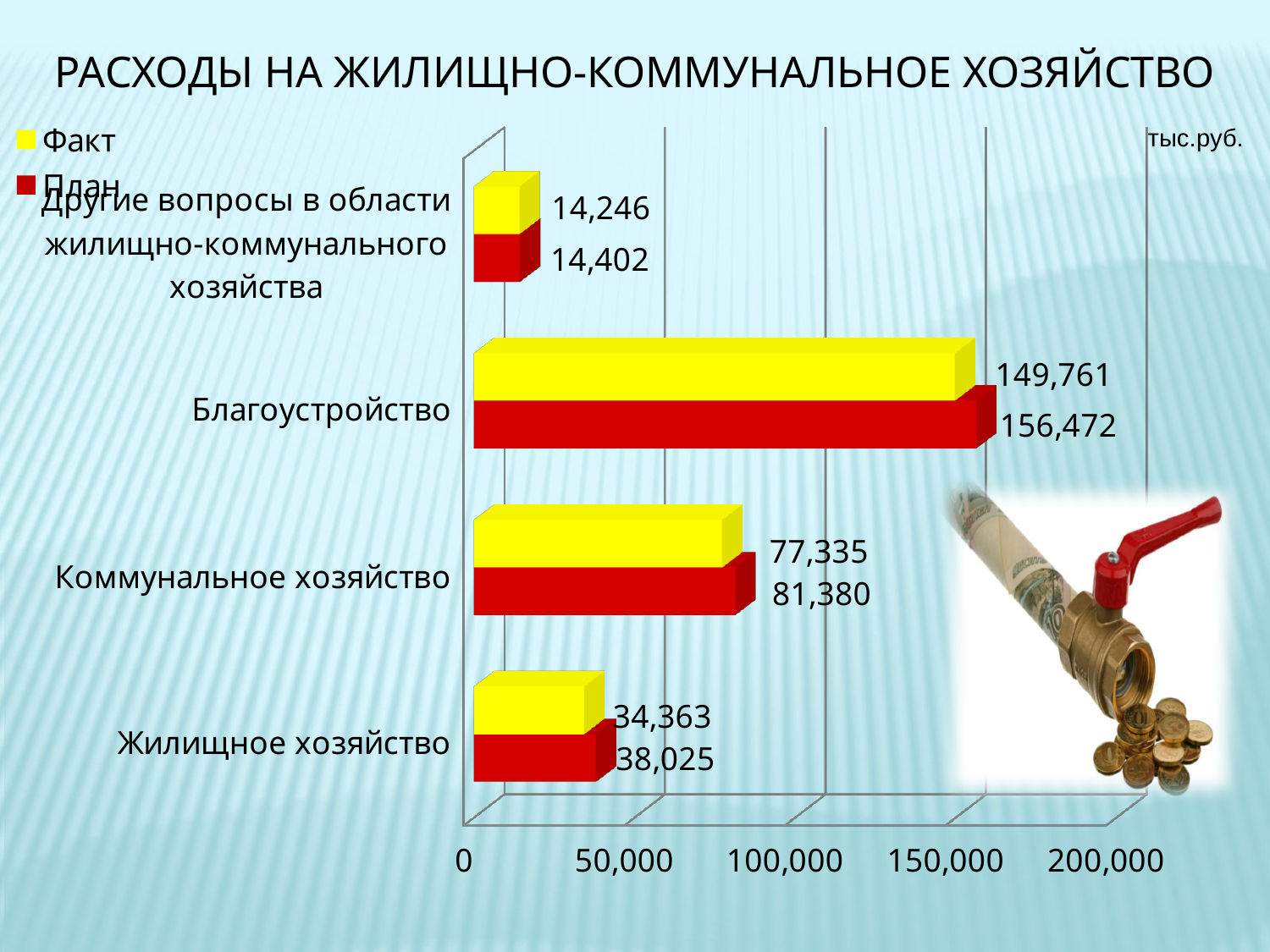
What is the difference between the План and Факт values for Жилищное хозяйство? 3,662 What is the Факт value for Жилищное хозяйство? 34,363 Which category has the lowest Факт value? Другие вопросы в области жилищно-коммунального хозяйства How many series does the legend list? 2 What is the difference between the План and Факт values for Благоустройство? 6,711 Which is larger for Коммунальное хозяйство: the Факт value or the План value? План Which category has the highest План value? Благоустройство What is the План value for Коммунальное хозяйство? 81,380 What is the План value for Другие вопросы в области жилищно-коммунального хозяйства? 14,402 What is the Факт value for Благоустройство? 149,761 How many categories are shown on the chart? 4 What kind of chart is shown on the slide? Bar chart